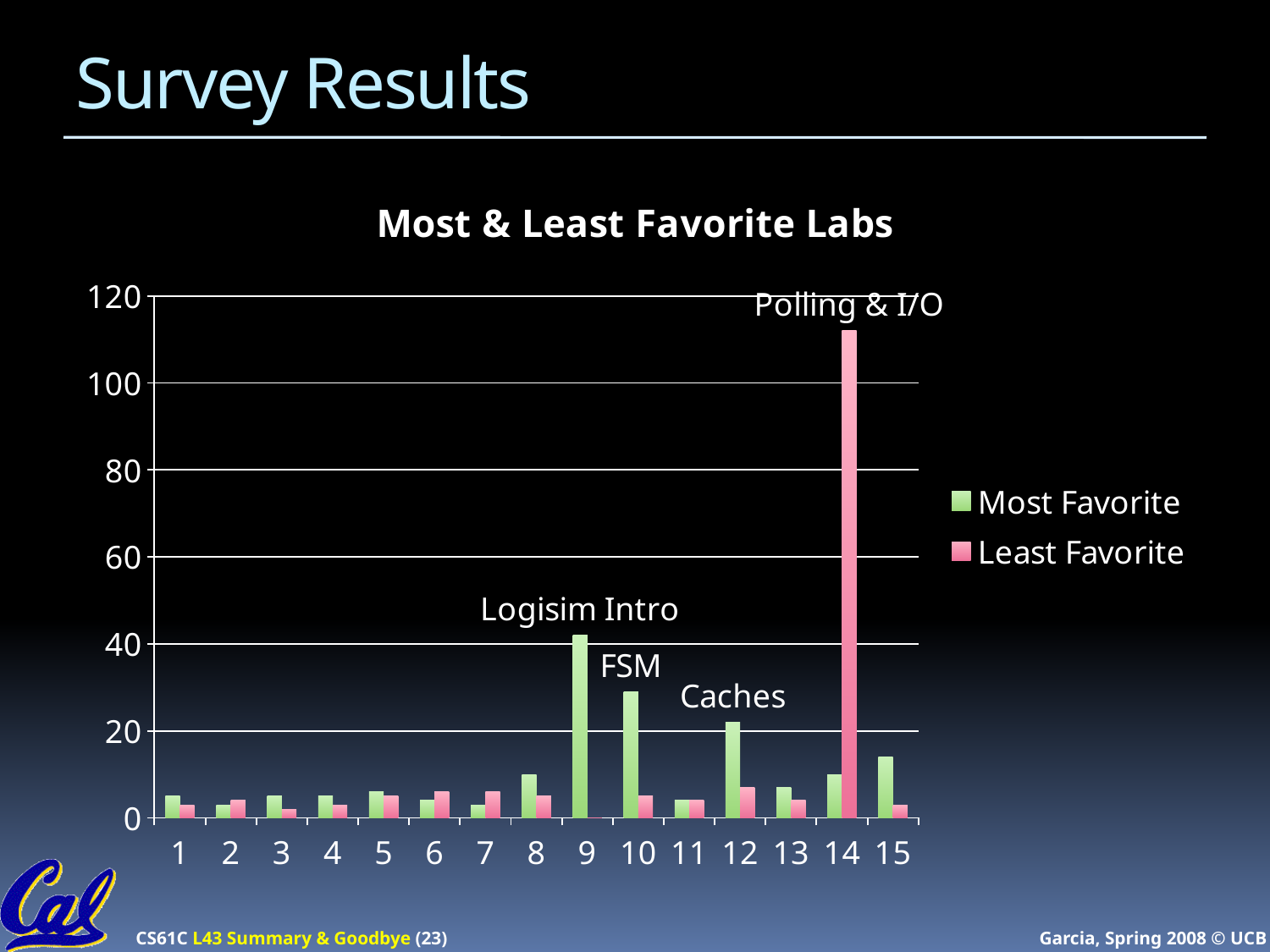
What kind of chart is shown on the slide? bar chart Which lab is annotated as "Polling & I/O" on the chart? 14 Which is larger for lab 14: the Most Favorite value or the Least Favorite value? Least Favorite Is the Least Favorite value for lab 14 greater or less than 100? greater What is the title of the chart? Most & Least Favorite Labs Is the Most Favorite value for lab 9 greater or less than 40? greater How many lab categories are shown on the x axis? 15 How many series does the legend list? 2 Which lab has the highest Least Favorite value? 14 Which lab has the highest Most Favorite value? 9 Is the Most Favorite value for lab 10 greater or less than 40? less Which is larger: the Most Favorite value for lab 9 or the Most Favorite value for lab 12? lab 9